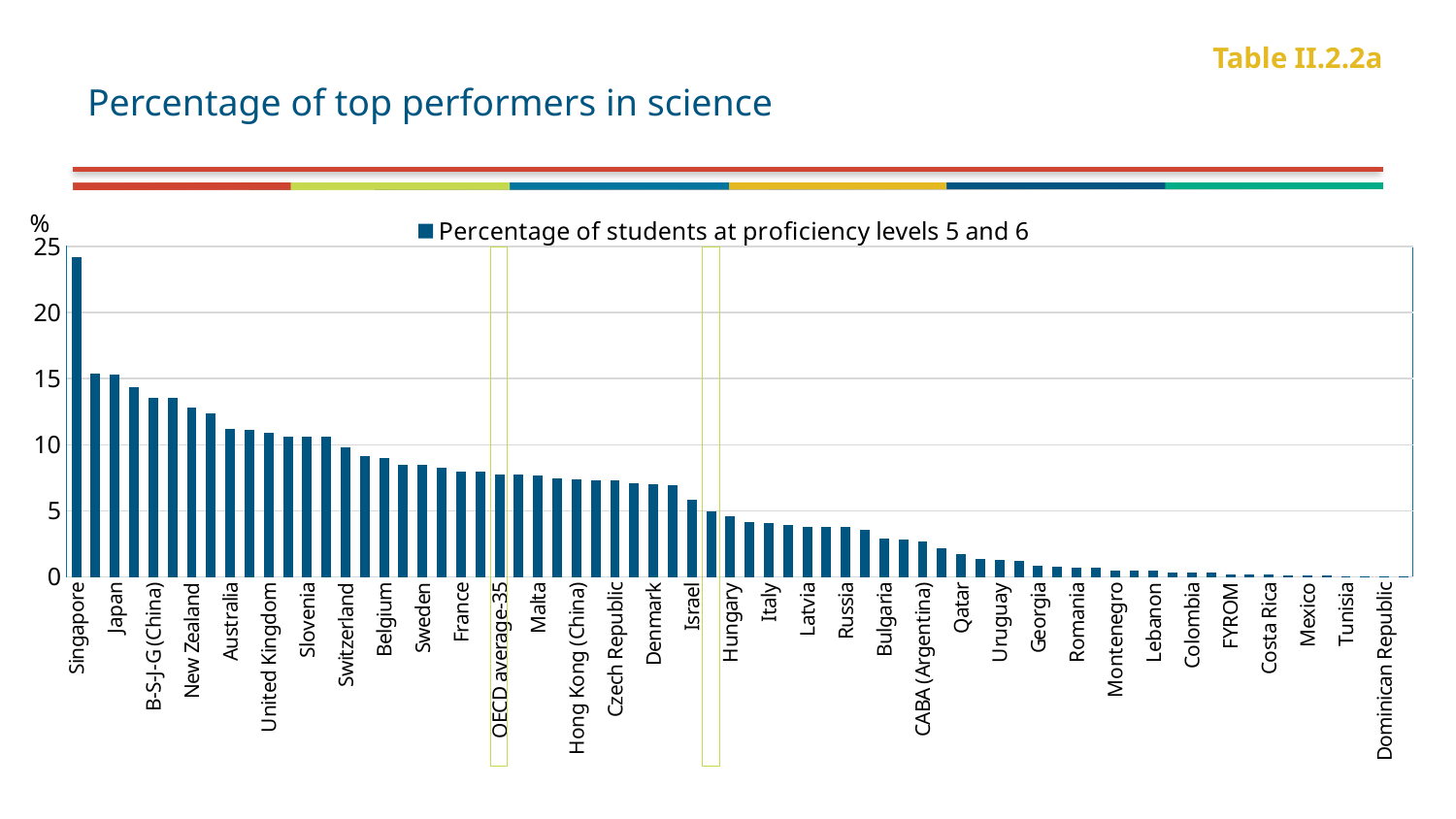
Which has a larger value, France or Israel? France Do the values rise or fall from left to right along the x axis? fall Is the value for Italy greater or less than 5? less Is the value for Australia greater or less than 10? greater Which country has the highest percentage of top performers in science? Singapore What kind of chart is shown on the slide? bar chart How many series does the legend list? 1 Is the value for Qatar greater or less than 5? less What is the title of the chart? Percentage of top performers in science